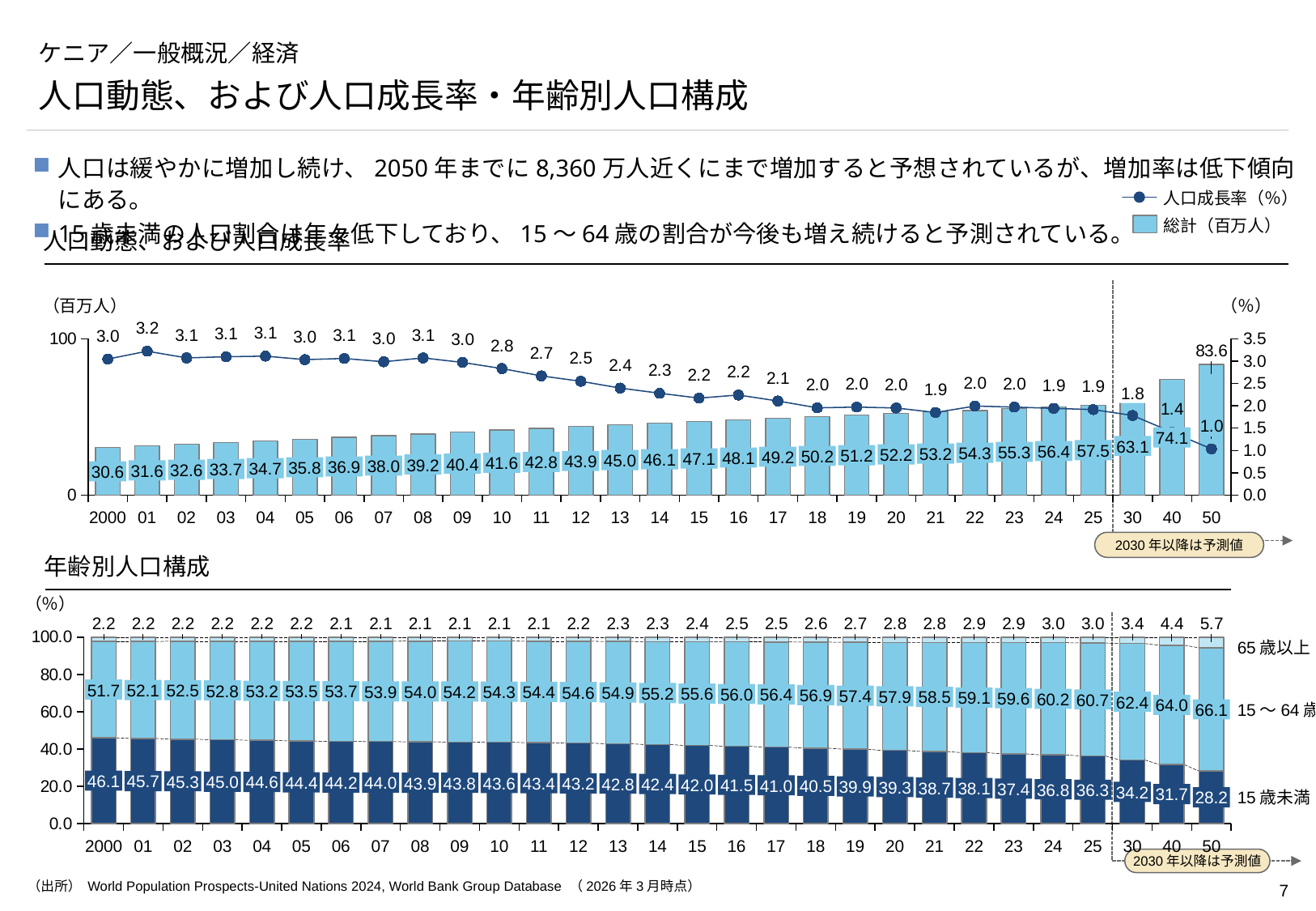
In the top chart (人口動態、および人口成長率), what is the total population (百万人) for 2000? 30.6 In the top chart (人口動態、および人口成長率), which year has the highest population growth rate? 2001 In the top chart (人口動態、および人口成長率), what is the difference between the total population in 2050 and in 2000 (百万人)? 53.0 In the bottom chart (年齢別人口構成), which is larger in 2050: the share of 15～64歳 or the share of 15歳未満? 15～64歳 In the top chart (人口動態、および人口成長率), what is the population growth rate (%) for 2050? 1.0 In the bottom chart (年齢別人口構成), how many years are shown on the x axis? 29 In the bottom chart (年齢別人口構成), does the share of 15歳未満 rise or fall from 2000 to 2050? fall In the top chart (人口動態、および人口成長率), how many series does the legend list? 2 In the bottom chart (年齢別人口構成), what is the share of 15歳未満 in 2000? 46.1 In the bottom chart (年齢別人口構成), what is the share of 65歳以上 in 2050? 5.7 In the bottom chart (年齢別人口構成), what is the total of the stacked bar for 2050? 100.0 In the top chart (人口動態、および人口成長率), does the population growth rate rise or fall from 2001 to 2050? fall